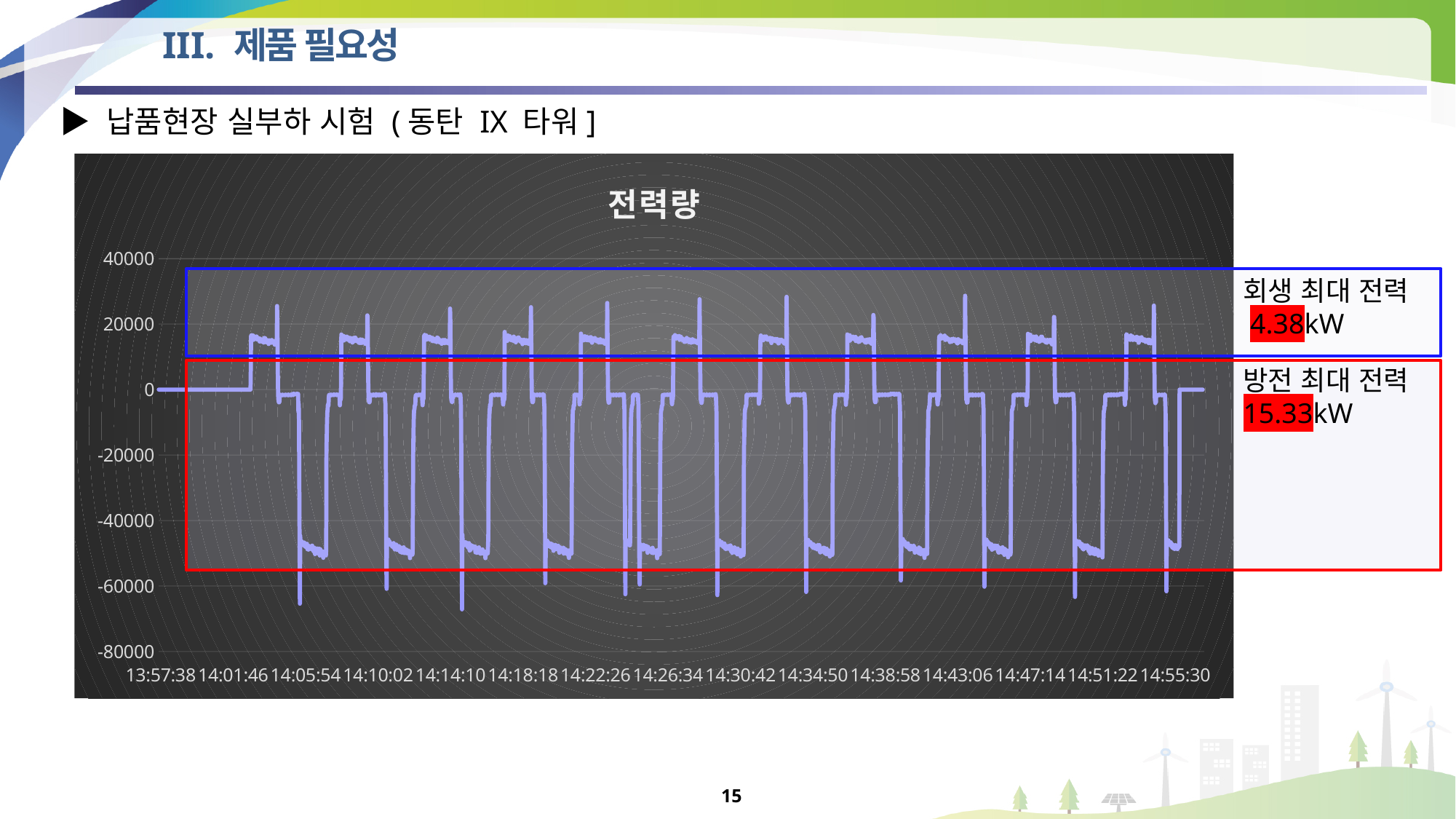
According to the annotation next to the chart, what is the 회생 최대 전력 (maximum regenerative power)? 4.38kW Are the lowest negative spikes of the line greater or less than -60000? less What is the lowest value shown on the chart's vertical axis? -80000 What is the title of the chart? 전력량 How many time labels are printed along the chart's horizontal axis? 15 What is the highest value shown on the chart's vertical axis? 40000 Which is larger in magnitude, the 방전 최대 전력 of 15.33kW or the 회생 최대 전력 of 4.38kW? 방전 최대 전력 (15.33kW) What is the first time label on the chart's horizontal axis? 13:57:38 What kind of chart is shown on the slide? line chart According to the annotation next to the chart, what is the 방전 최대 전력 (maximum discharge power)? 15.33kW Are the highest positive spikes of the line greater or less than 20000? greater What is the last time label on the chart's horizontal axis? 14:55:30